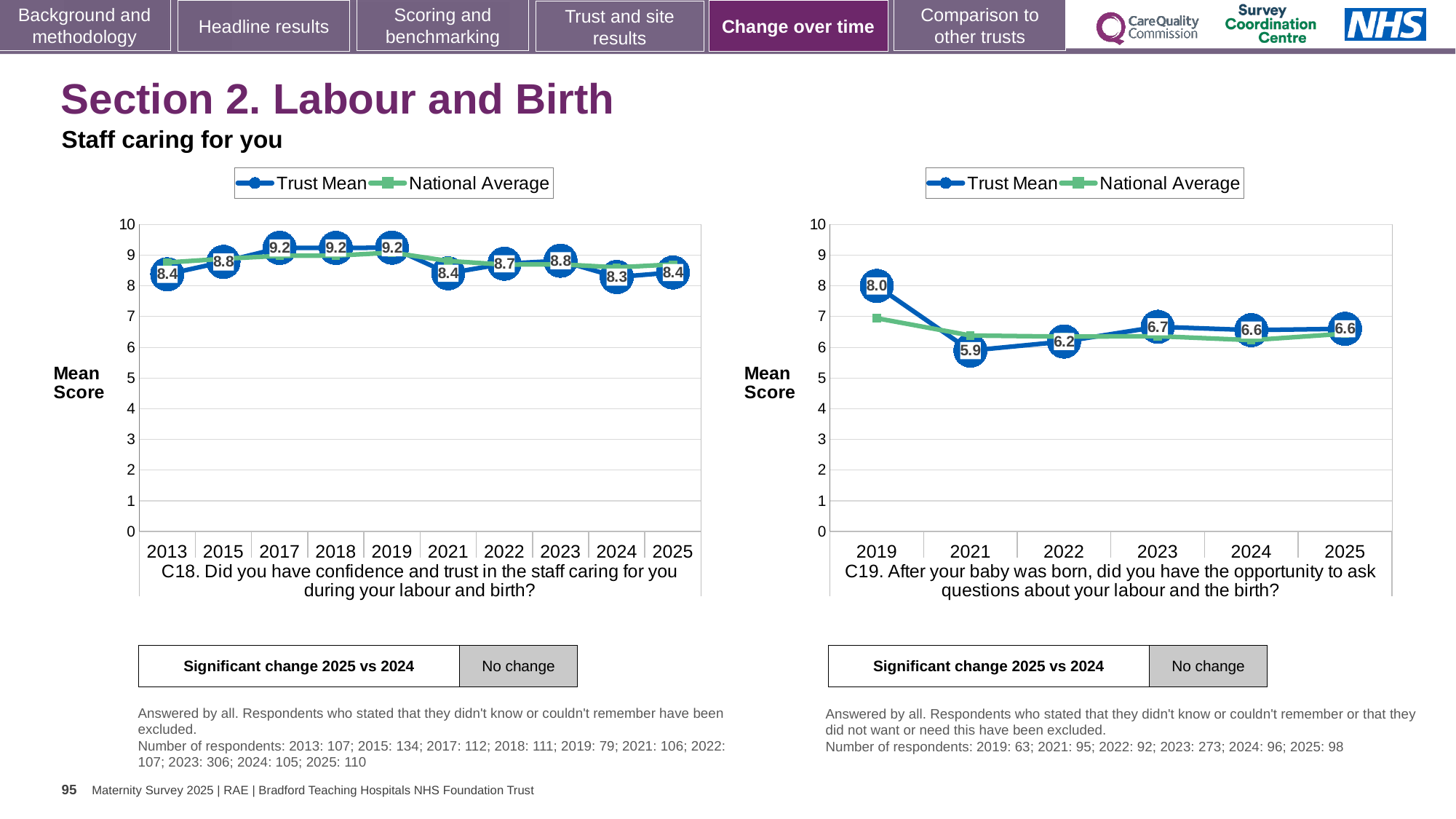
On the C18 chart (left), what is the Trust Mean score for 2025? 8.4 On the C18 chart (left), what is the difference between the Trust Mean scores for 2019 and 2024? 0.9 On the C19 chart (right), what is the difference between the Trust Mean scores for 2019 and 2021? 2.1 On the C18 chart (left), which year has the lowest Trust Mean score? 2024 How many series does the legend of the C18 chart (left) list? 2 On the C18 chart (left), what is the Trust Mean score for 2015? 8.8 On the C19 chart (right), is the Trust Mean score for 2023 larger or smaller than the score for 2022? larger On the C19 chart (right), what is the Trust Mean score for 2021? 5.9 On the C19 chart (right), what is the Trust Mean score for 2019? 8.0 On the C19 chart (right), which year has the highest Trust Mean score? 2019 On the C18 chart (left), how many years are shown on the x axis? 10 On the C19 chart (right), is the National Average value for 2019 greater or less than 6? greater